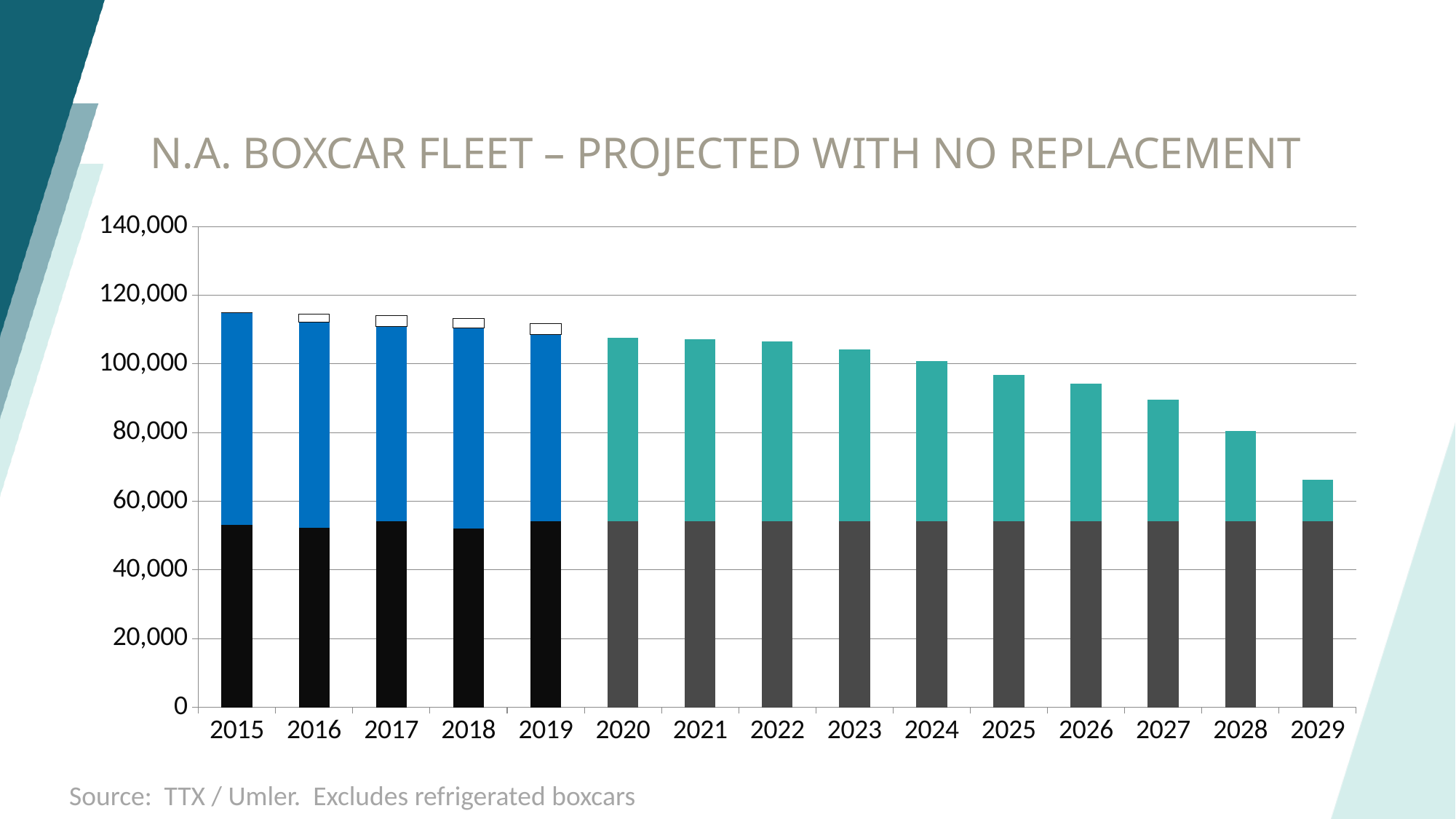
How many years are shown along the x axis of the chart? 15 Is the total bar height for 2015 greater or less than 100,000? greater Is the total bar height for 2027 greater or less than 100,000? less What is the title of the chart? N.A. BOXCAR FLEET – PROJECTED WITH NO REPLACEMENT What is the highest value shown on the y axis of the chart? 140,000 Is the total bar height for 2025 greater or less than 80,000? greater Do the bar heights rise or fall from 2015 to 2029? Fall Which year has the shortest bar in the chart? 2029 Which bar is taller, 2020 or 2028? 2020 Which year has the tallest bar in the chart? 2015 What kind of chart is shown on the slide? Stacked bar chart